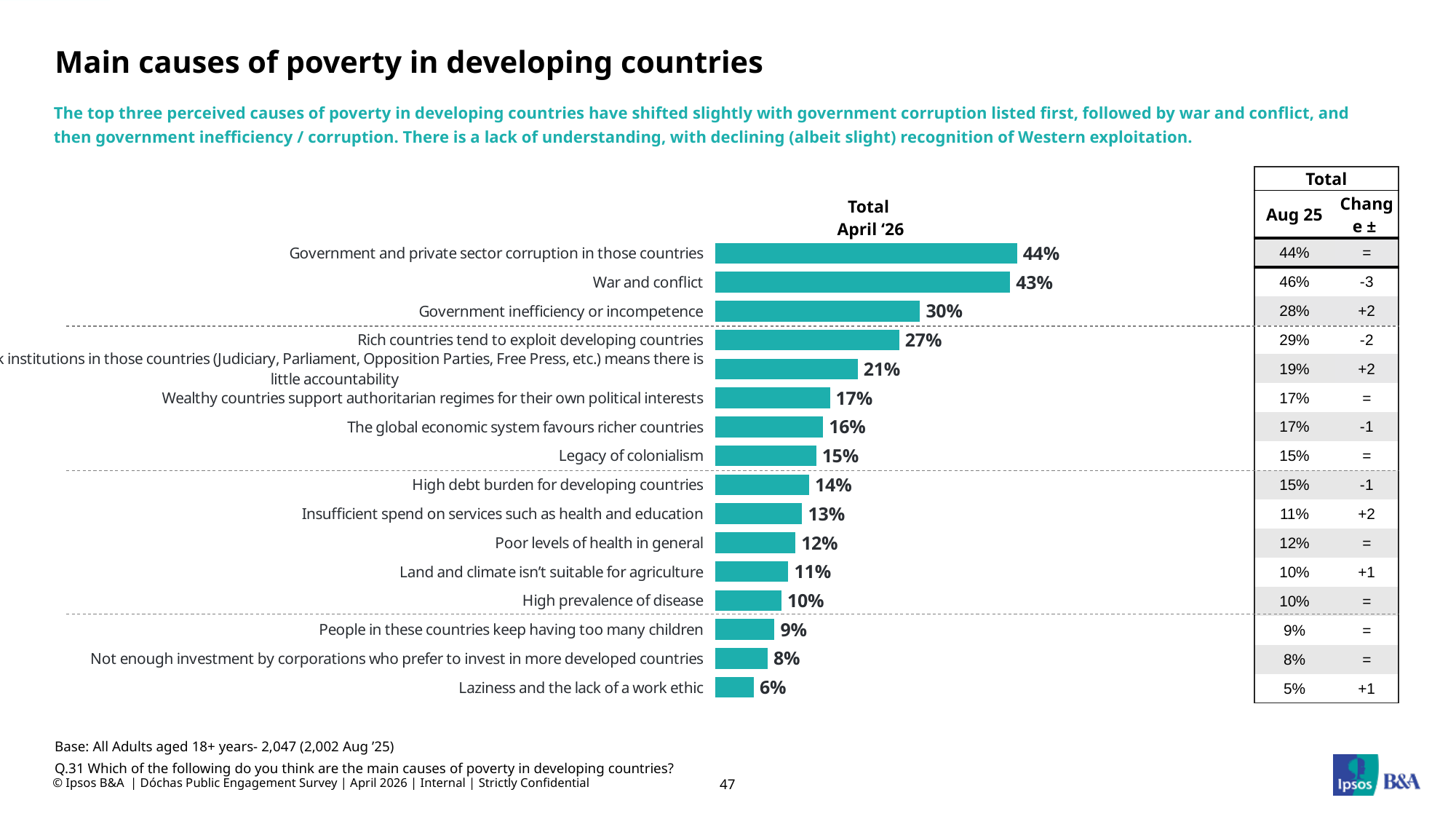
What is the difference between Government inefficiency or incompetence and Rich countries tend to exploit developing countries? 3% What kind of chart is shown? Bar chart Which is larger: High debt burden for developing countries or Poor levels of health in general? High debt burden for developing countries What is the value for Laziness and the lack of a work ethic? 6% How many causes are plotted in the chart? 16 What is the difference between the highest and lowest values in the chart? 38% Which cause has the highest value? Government and private sector corruption in those countries What is the value for Legacy of colonialism? 15% What is the value for War and conflict? 43% Which cause has the lowest value? Laziness and the lack of a work ethic What is the value for High prevalence of disease? 10% What is the heading above the bars in the chart? Total April '26